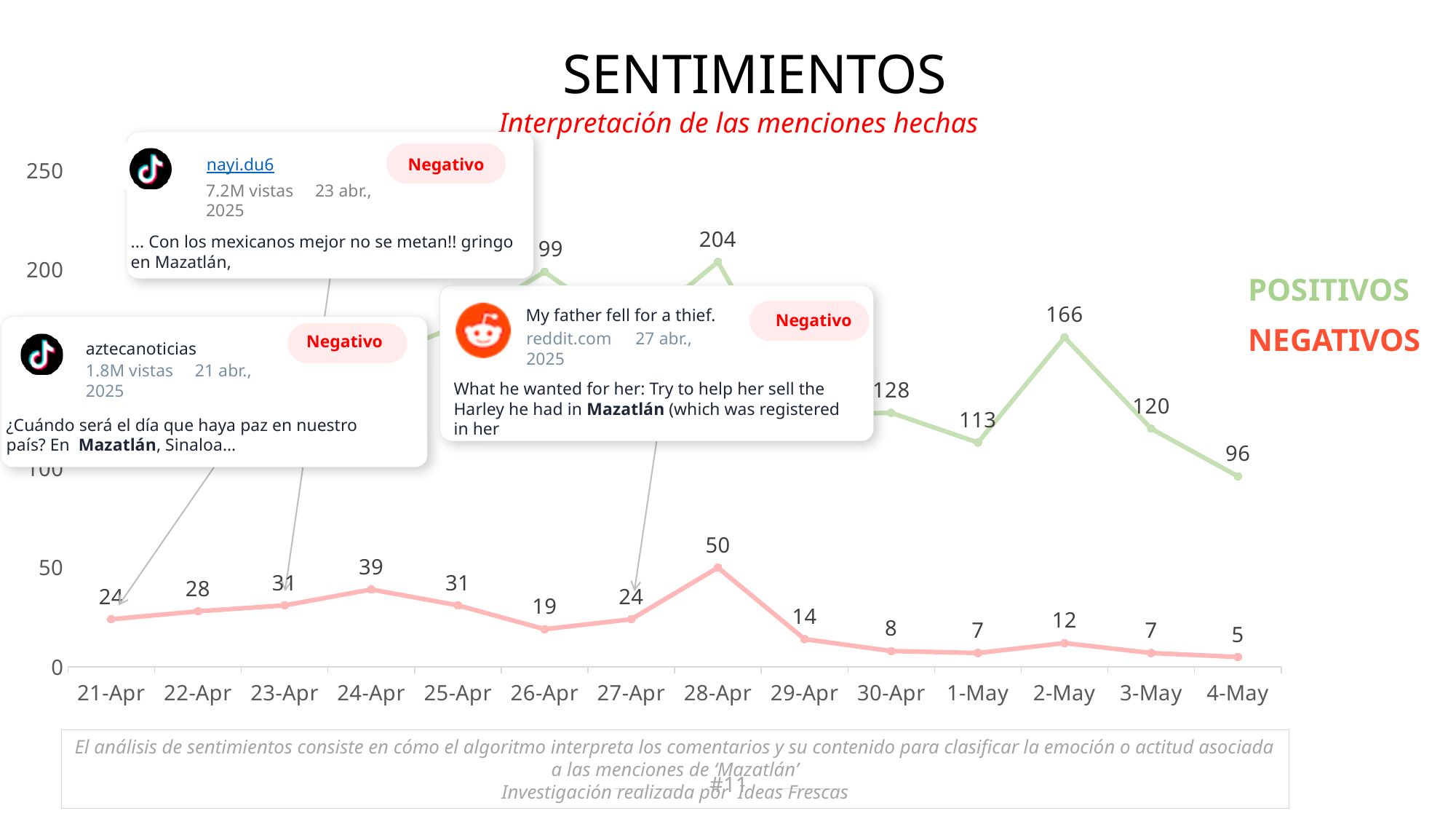
On which date is the NEGATIVOS value lowest? 4-May On which date is the NEGATIVOS value highest? 28-Apr What is the POSITIVOS value on 2-May? 166 What kind of chart is shown on the slide? line chart Do the POSITIVOS values rise or fall from 2-May to 4-May? fall What is the POSITIVOS value on 4-May? 96 What is the difference between the POSITIVOS values on 2-May and 3-May? 46 Which date has the larger POSITIVOS value, 30-Apr or 1-May? 30-Apr What colour is the NEGATIVOS line? red (pink) What is the NEGATIVOS value on 28-Apr? 50 How many dates are shown on the x axis? 14 How many series does the chart show? 2